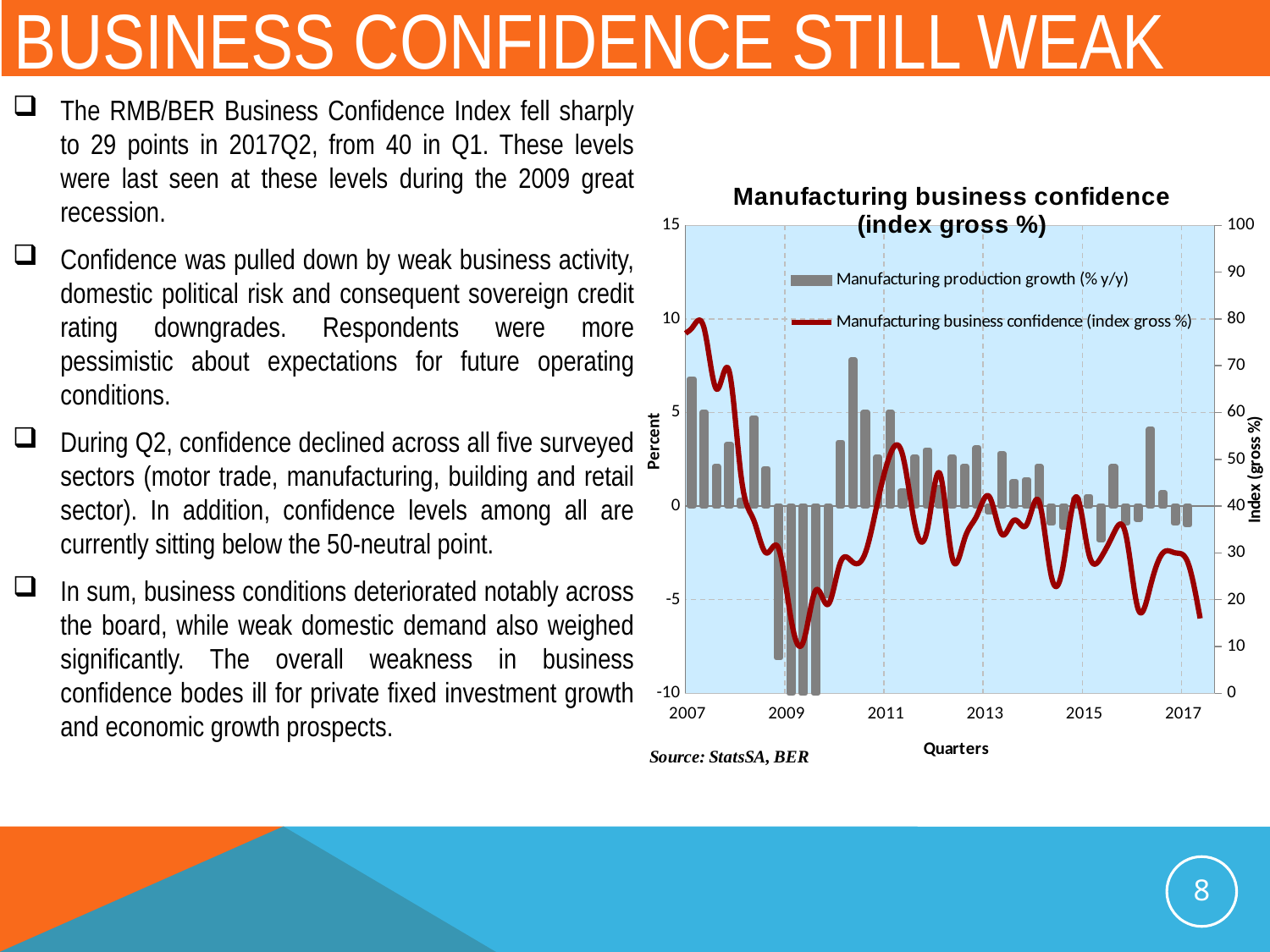
What is the maximum value shown on the right-hand axis? 100 Which series is plotted as bars? Manufacturing production growth (% y/y) What kind of chart is shown on the slide? Combined bar and line chart Does the manufacturing business confidence line overall rise or fall from 2007 to 2017? fall Is the tallest manufacturing production growth bar in 2010 greater or less than 5? greater What is the label of the x axis? Quarters Is the lowest manufacturing production growth bar in 2009 greater or less than -5? less What is the title of the chart? Manufacturing business confidence (index gross %) Is the manufacturing business confidence index at its 2011 peak greater or less than 40? greater What is the minimum value shown on the left-hand axis? -10 How many series does the chart legend list? 2